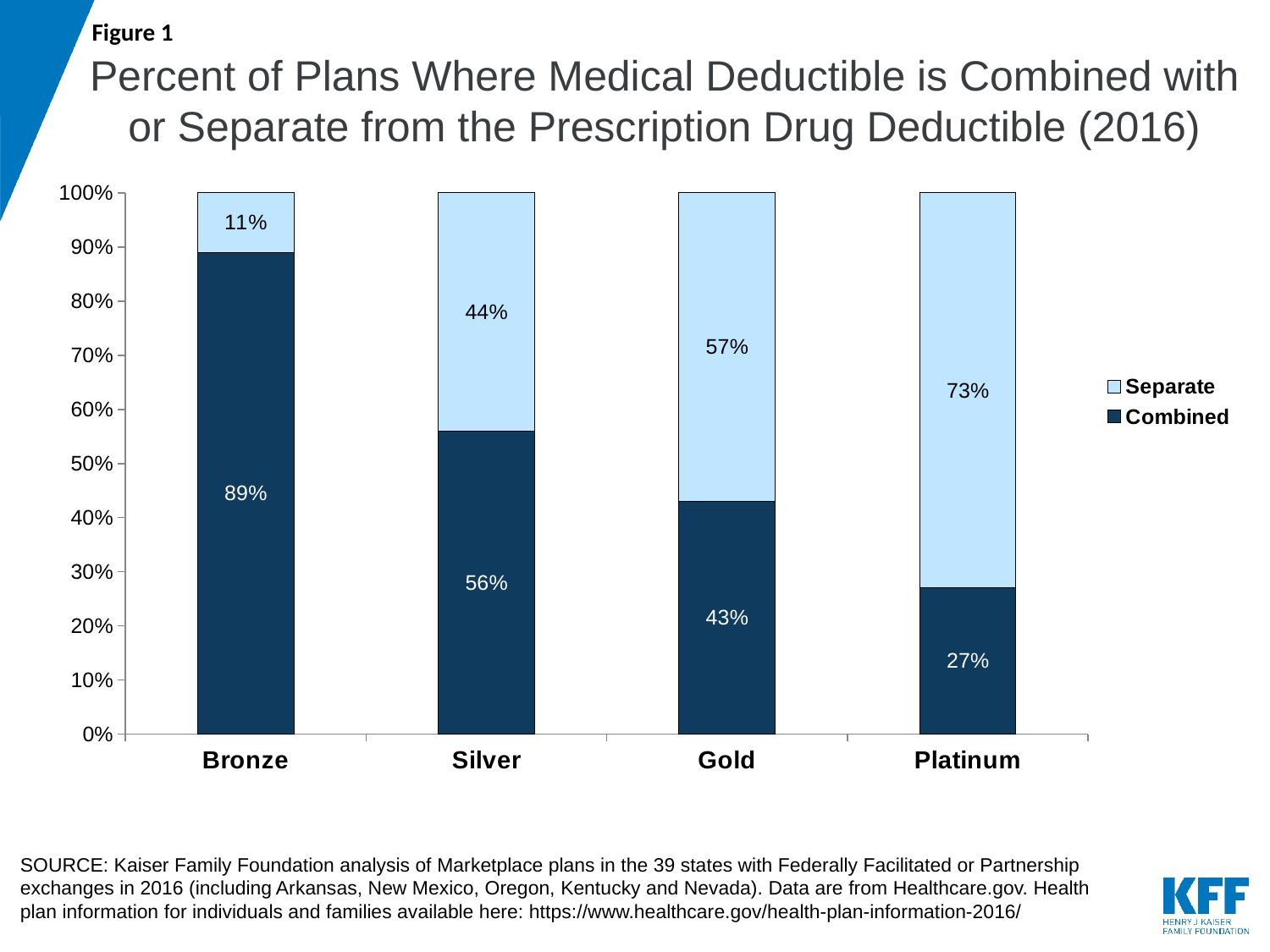
Does the Combined percentage rise or fall moving from Bronze to Platinum? Fall What percent of Silver plans have a Separate deductible? 44% What percent of Gold plans have a Combined deductible? 43% What percent of Platinum plans have a Separate deductible? 73% What kind of chart is shown on the slide? Stacked bar chart Which is larger: the Separate share for Gold plans or the Separate share for Silver plans? Gold Which metal level has the highest percent of plans with a Combined deductible? Bronze How many metal levels are shown on the x axis? 4 How many series does the legend list? 2 Which metal level has the lowest percent of plans with a Separate deductible? Bronze What is the difference between the Combined percentages for Bronze and Platinum plans? 62% What percent of Bronze plans have a Combined deductible? 89%